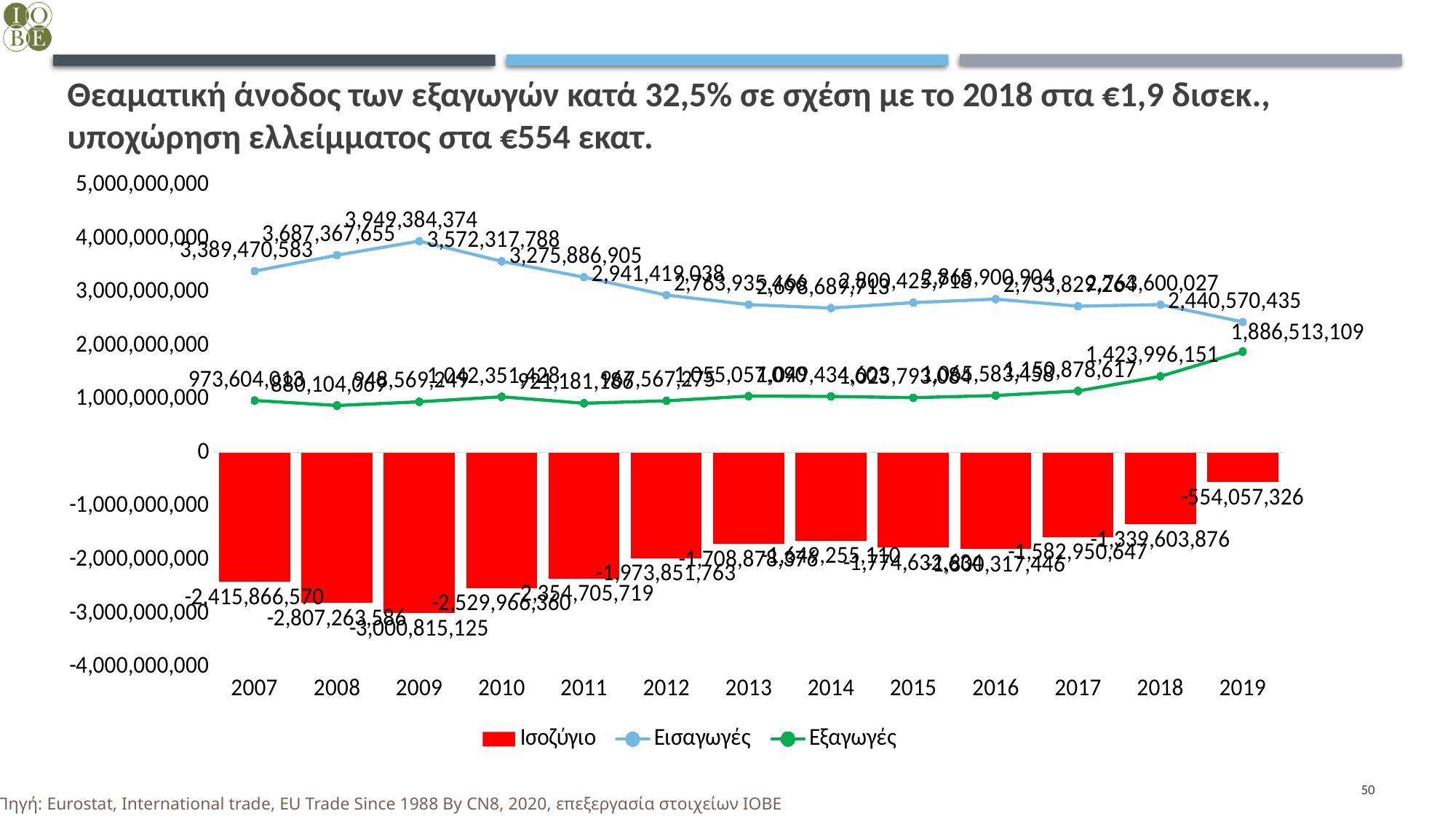
How many series does the legend list? 3 Is the value of Εξαγωγές (exports) in 2019 greater or less than 1,000,000,000? greater What is the value of Εισαγωγές (imports) in 2009? 3,949,384,374 What is the difference between Εισαγωγές (2,440,570,435) and Εξαγωγές (1,886,513,109) in 2019? 554,057,326 In which year are Εισαγωγές (imports) highest? 2009 What is the value of Ισοζύγιο (balance) in 2009? -3,000,815,125 What is the value of Εξαγωγές (exports) in 2019? 1,886,513,109 How many years are shown on the x axis? 13 In which year is the Ισοζύγιο (balance) most negative? 2009 What kind of chart is shown on the slide? A combined bar and line chart What is the value of Ισοζύγιο (balance) in 2019? -554,057,326 In which year are Εξαγωγές (exports) highest? 2019